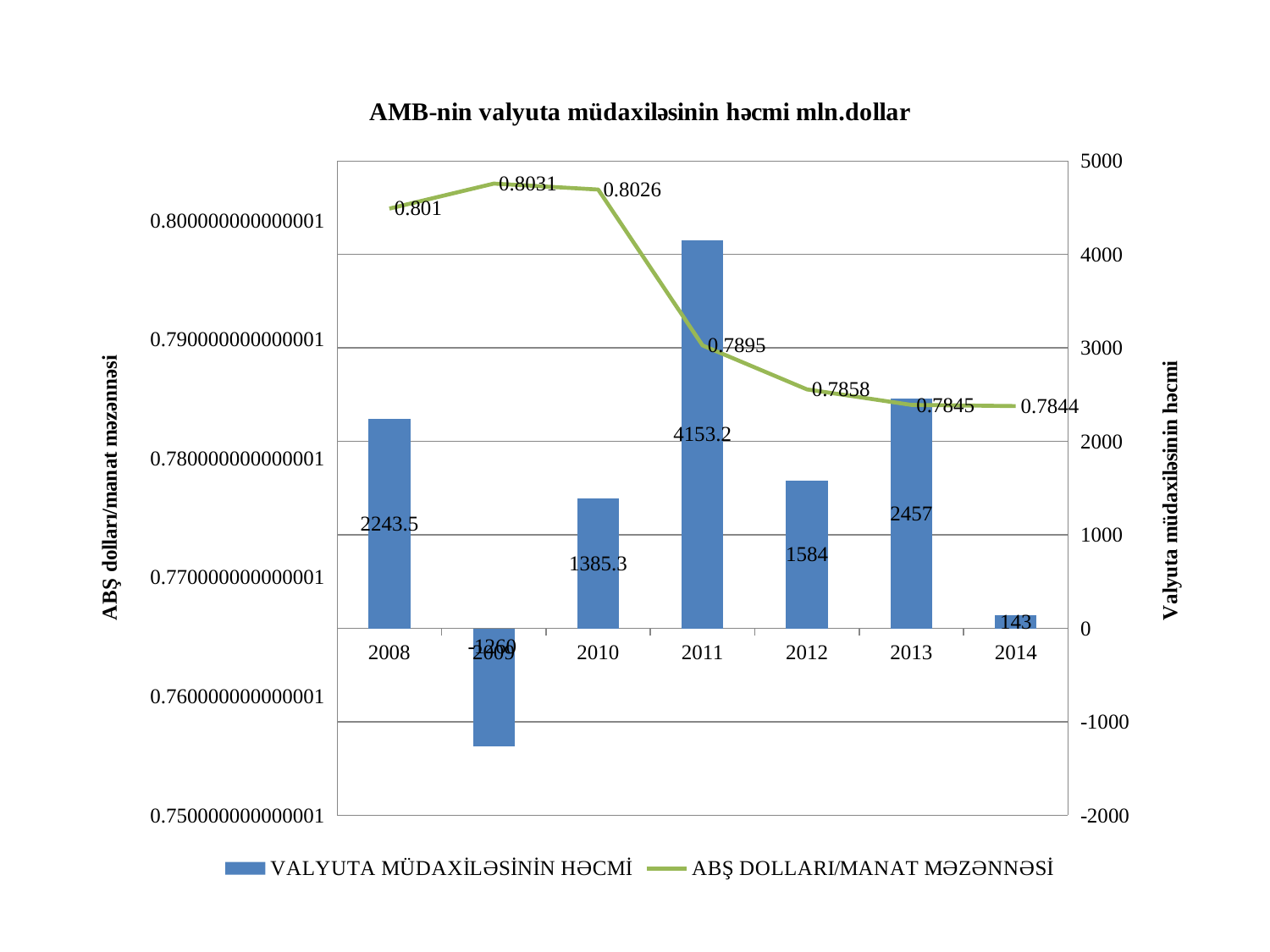
In which year is the ABŞ DOLLARI/MANAT MƏZƏNNƏSİ line at its highest labelled value? 2009 Which year has the lowest currency intervention volume bar? 2009 What is the currency intervention volume shown for 2014? 143 Which year has the larger currency intervention volume, 2008 or 2013? 2013 How many years are shown on the x axis of the chart? 7 Which year has the highest currency intervention volume bar? 2011 How many series does the legend list? 2 What is the value of the currency intervention volume (VALYUTA MÜDAXİLƏSİNİN HƏCMİ) bar for 2011? 4153.2 What is the ABŞ DOLLARI/MANAT MƏZƏNNƏSİ value shown for 2012? 0.7858 Does the ABŞ DOLLARI/MANAT MƏZƏNNƏSİ line rise or fall from 2010 to 2014? fall Is the currency intervention volume bar for 2010 greater or less than 1000? greater What is the difference between the currency intervention volumes for 2013 and 2012? 873